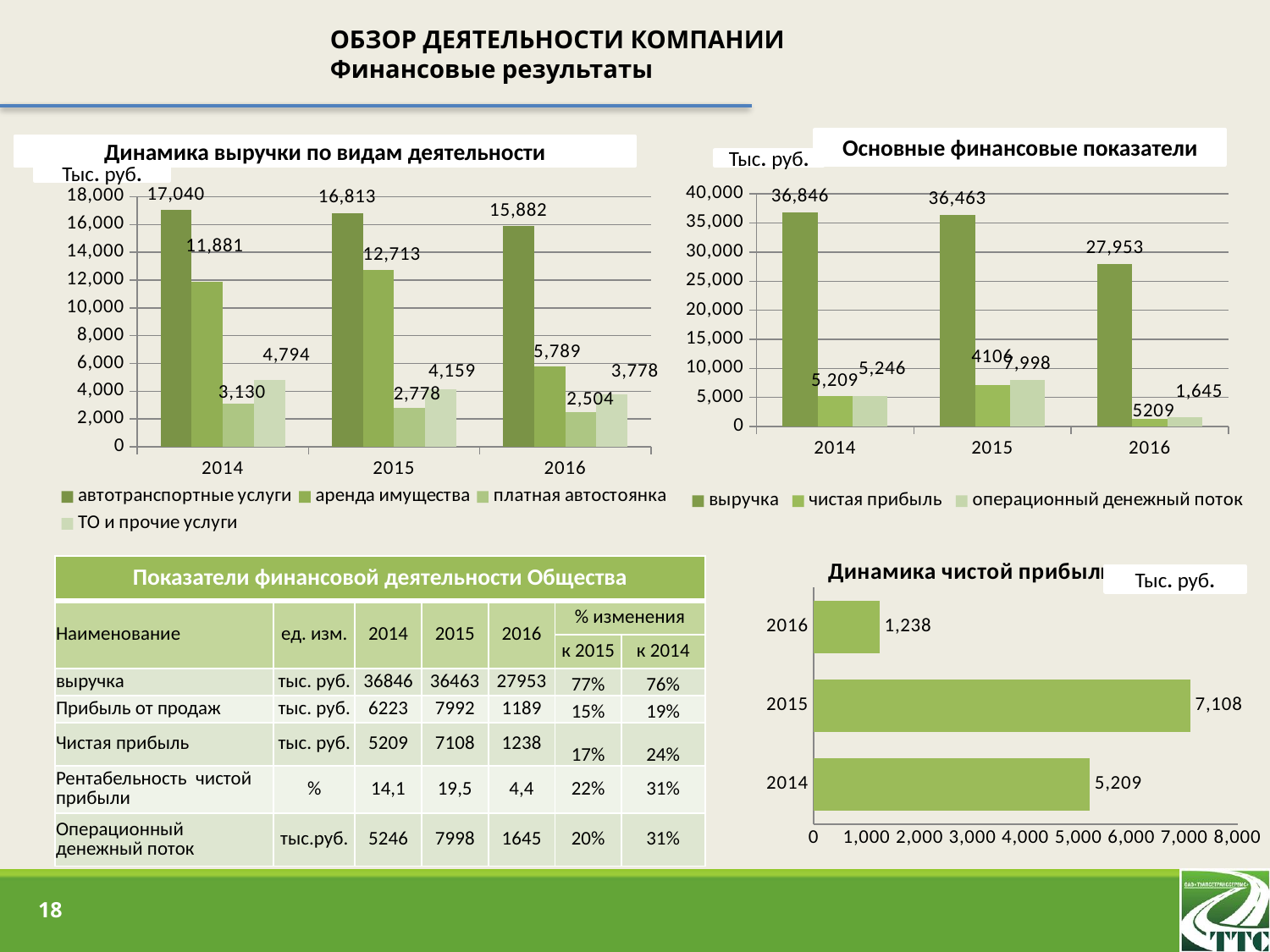
In the chart 'Динамика выручки по видам деятельности', does the value for автотранспортные услуги rise or fall from 2014 to 2016? fall In the chart 'Динамика выручки по видам деятельности', what is the value for аренда имущества in 2016? 5,789 In the chart 'Динамика выручки по видам деятельности', how many series does the legend list? 4 In the chart 'Основные финансовые показатели', which year has the highest выручка? 2014 In the chart 'Основные финансовые показатели', is the value for выручка in 2015 greater or less than 35,000? greater In the chart 'Динамика выручки по видам деятельности', what is the value for автотранспортные услуги in 2014? 17,040 In the chart 'Основные финансовые показатели', what is the value for выручка in 2016? 27,953 In the chart 'Основные финансовые показатели', what is the value for операционный денежный поток in 2016? 1,645 In the chart 'Динамика чистой прибыли', what is the difference between the 2015 and 2014 values? 1,899 What kind of chart is 'Динамика чистой прибыли'? bar chart In the chart 'Динамика выручки по видам деятельности', what is the difference between автотранспортные услуги in 2014 and in 2016? 1,158 In the chart 'Динамика чистой прибыли', which year has the lowest value? 2016